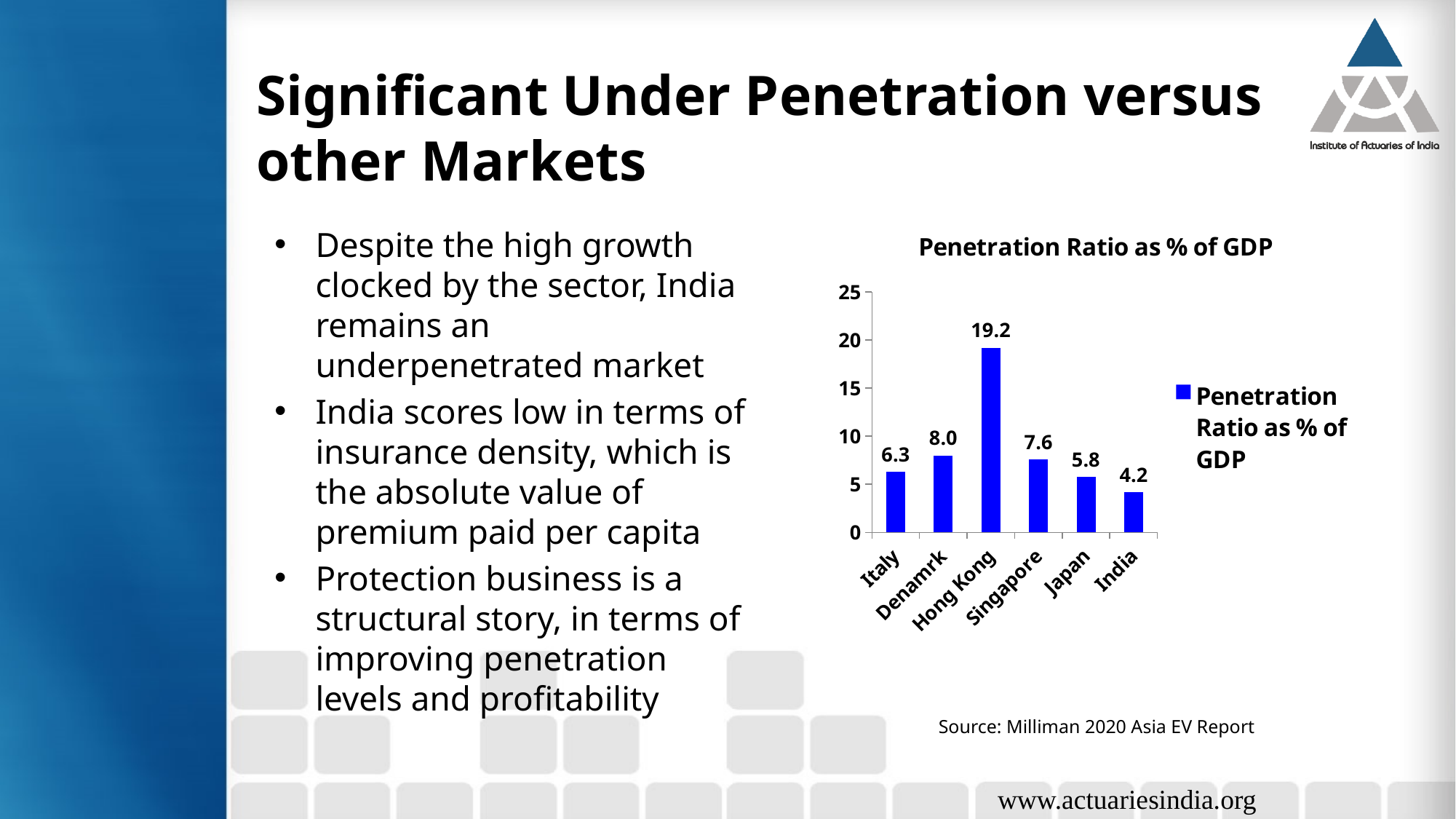
What is the difference between the penetration ratios of Denamrk and Italy? 1.7 What is the title of the chart? Penetration Ratio as % of GDP Which country has the highest penetration ratio as % of GDP? Hong Kong What is the difference between the penetration ratios of Hong Kong and India? 15.0 Which country has the lowest penetration ratio as % of GDP? India Is the penetration ratio for Hong Kong greater or less than 15? greater What is the penetration ratio as % of GDP for India? 4.2 Which has a higher penetration ratio, Japan or Singapore? Singapore What is the penetration ratio as % of GDP for Hong Kong? 19.2 What type of chart is used to show the penetration ratio as % of GDP? Bar chart How many countries are shown in the chart? 6 What is the penetration ratio as % of GDP for Singapore? 7.6